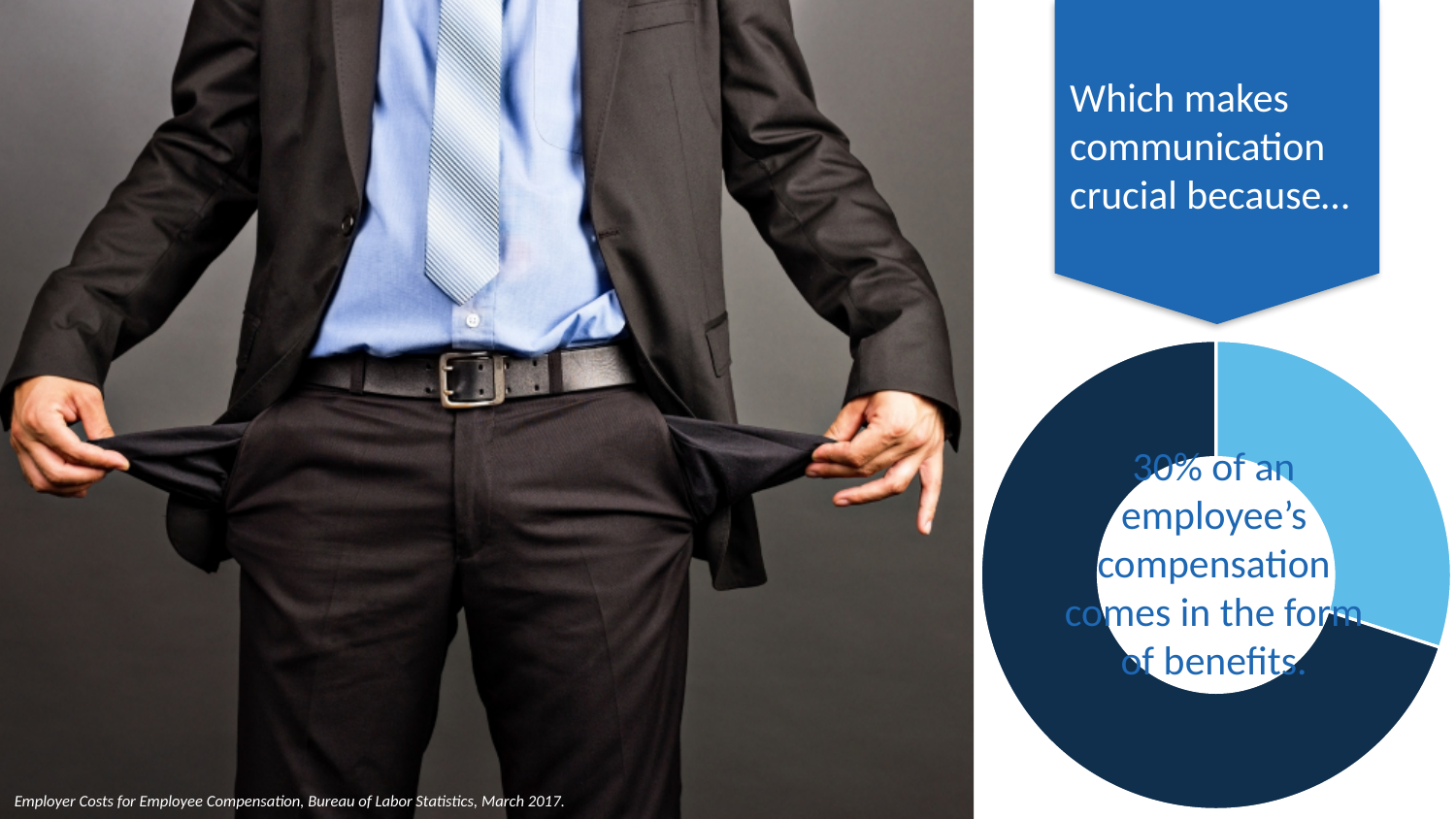
According to the text in the centre of the doughnut chart, what share of an employee's compensation comes in the form of benefits? 30% What text appears in the blue banner above the doughnut chart? Which makes communication crucial because… What does the light blue slice of the doughnut chart represent? The 30% of an employee's compensation that comes in the form of benefits What source is cited at the bottom of the slide for the chart data? Employer Costs for Employee Compensation, Bureau of Labor Statistics, March 2017. Is the dark navy slice of the doughnut chart greater or less than 50% of the whole? greater Which slice of the doughnut chart represents the smaller share? The light blue slice Is the light blue slice of the doughnut chart greater or less than 50% of the whole? less How many slices does the doughnut chart on the slide have? 2 Which slice of the doughnut chart is larger, the light blue slice or the dark navy slice? The dark navy slice What kind of chart is shown on the right side of the slide? Pie chart (doughnut)